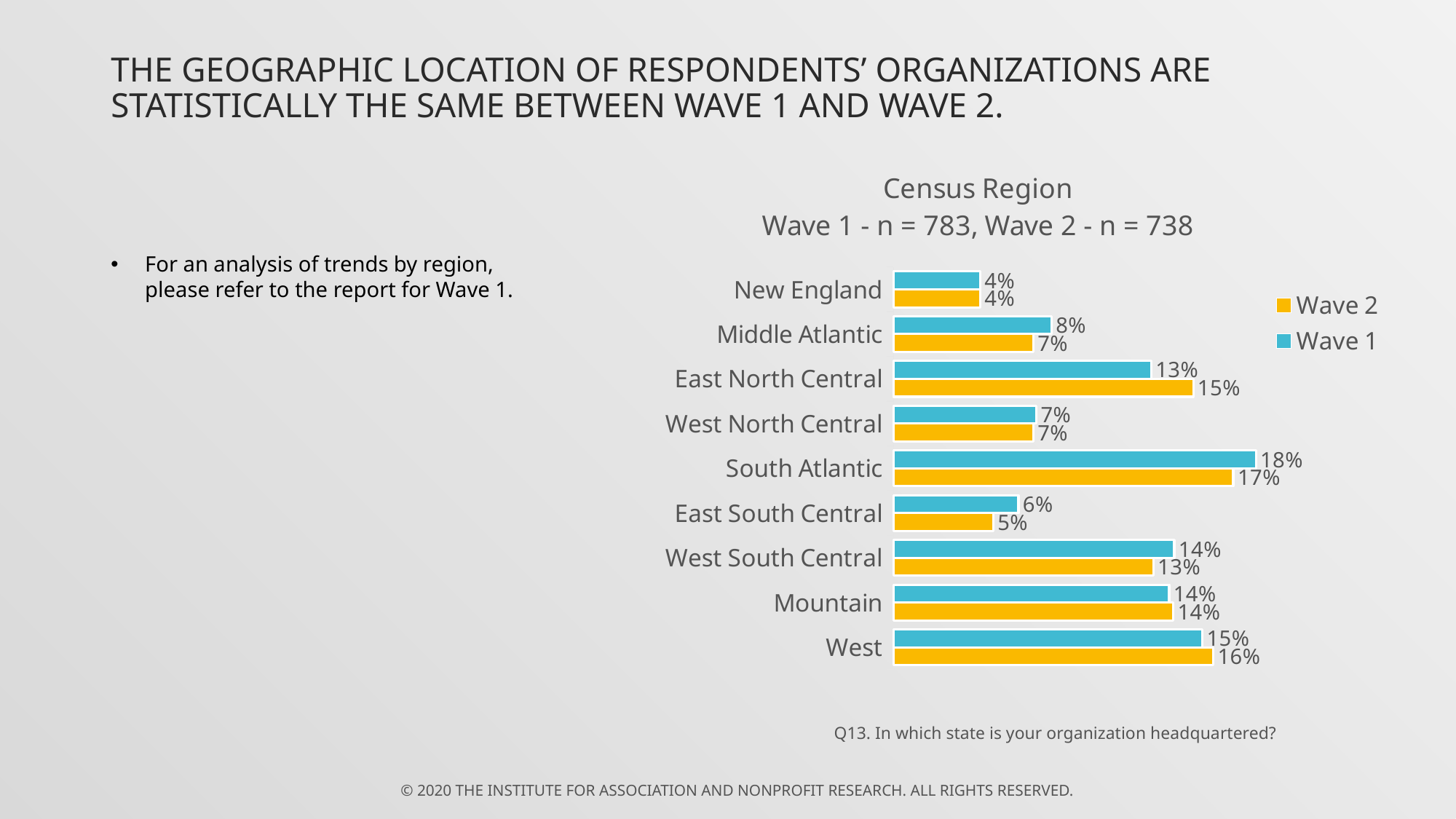
What is the Wave 2 value for East South Central? 5% How many series does the legend list? 2 What is the Wave 1 value for South Atlantic? 18% What kind of chart is shown on the slide? Bar chart How many regions are shown on the chart? 9 What is the Wave 2 value for East North Central? 15% What is the Wave 1 value for Middle Atlantic? 8% Which is larger for West: the Wave 1 value or the Wave 2 value? Wave 2 Which colour represents Wave 2 in the chart? Yellow What is the difference between the Wave 1 and Wave 2 values for East North Central? 2% Which region has the highest Wave 1 value? South Atlantic Which region has the lowest Wave 2 value? New England